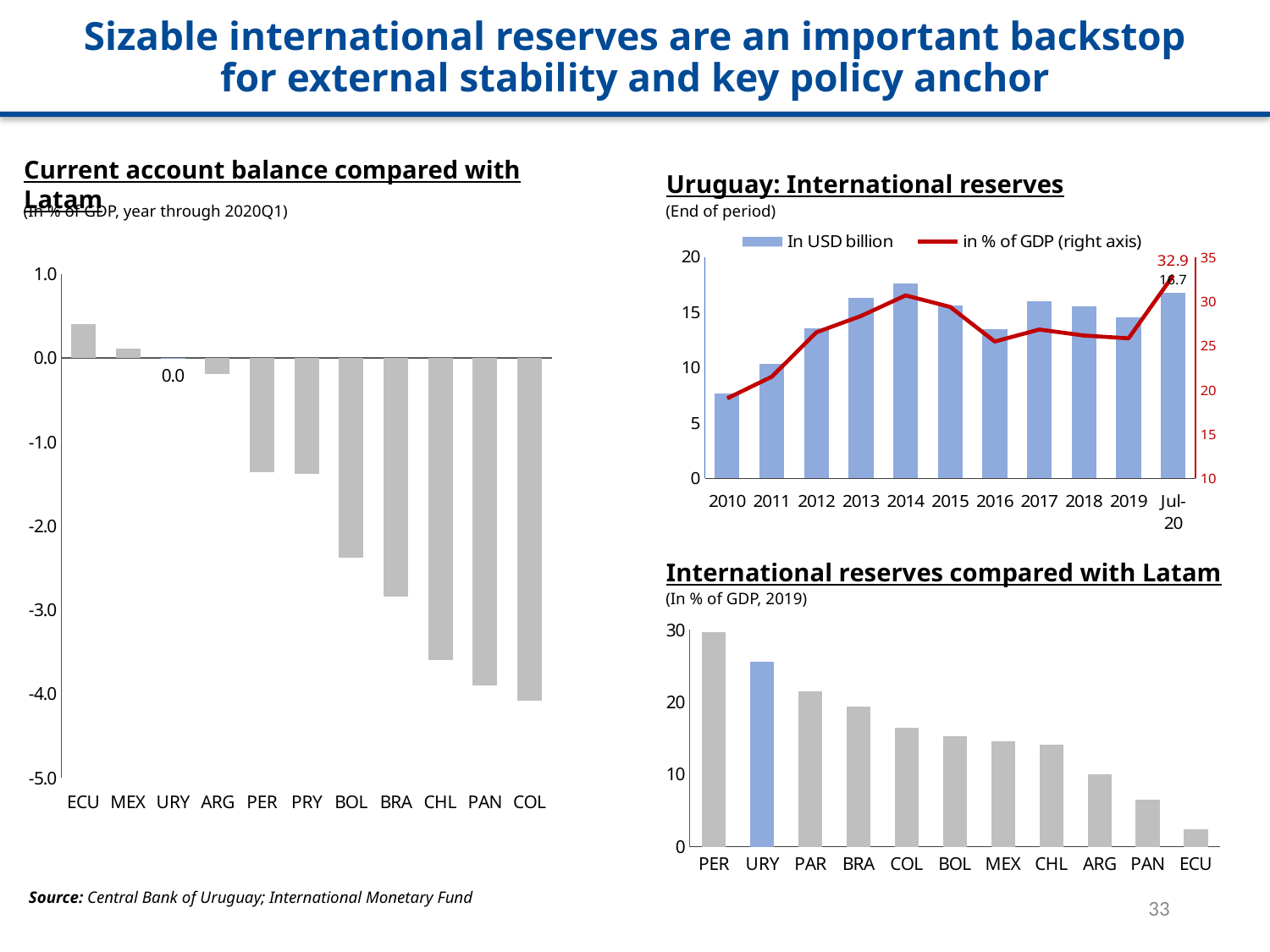
How many series does the legend of the 'Uruguay: International reserves' chart list? 2 In the 'Current account balance compared with Latam' chart, which country has the lowest current account balance? COL In the 'International reserves compared with Latam' chart, which bar is highlighted in blue? URY In the 'International reserves compared with Latam' chart, which country has the lowest value? ECU How many countries are shown in the 'Current account balance compared with Latam' chart? 11 In the 'Current account balance compared with Latam' chart, is the value for CHL greater or less than -3.0? less In the 'Current account balance compared with Latam' chart, which country has the highest current account balance? ECU In the 'Current account balance compared with Latam' chart, what value is printed for URY? 0.0 In the 'International reserves compared with Latam' chart, which country has the highest value? PER In the 'Uruguay: International reserves' chart, is the USD billion value for 2010 greater or less than 10? less In the 'Current account balance compared with Latam' chart, do the values rise or fall from left to right? fall In the 'Uruguay: International reserves' chart, what is the value in % of GDP for Jul-20? 32.9